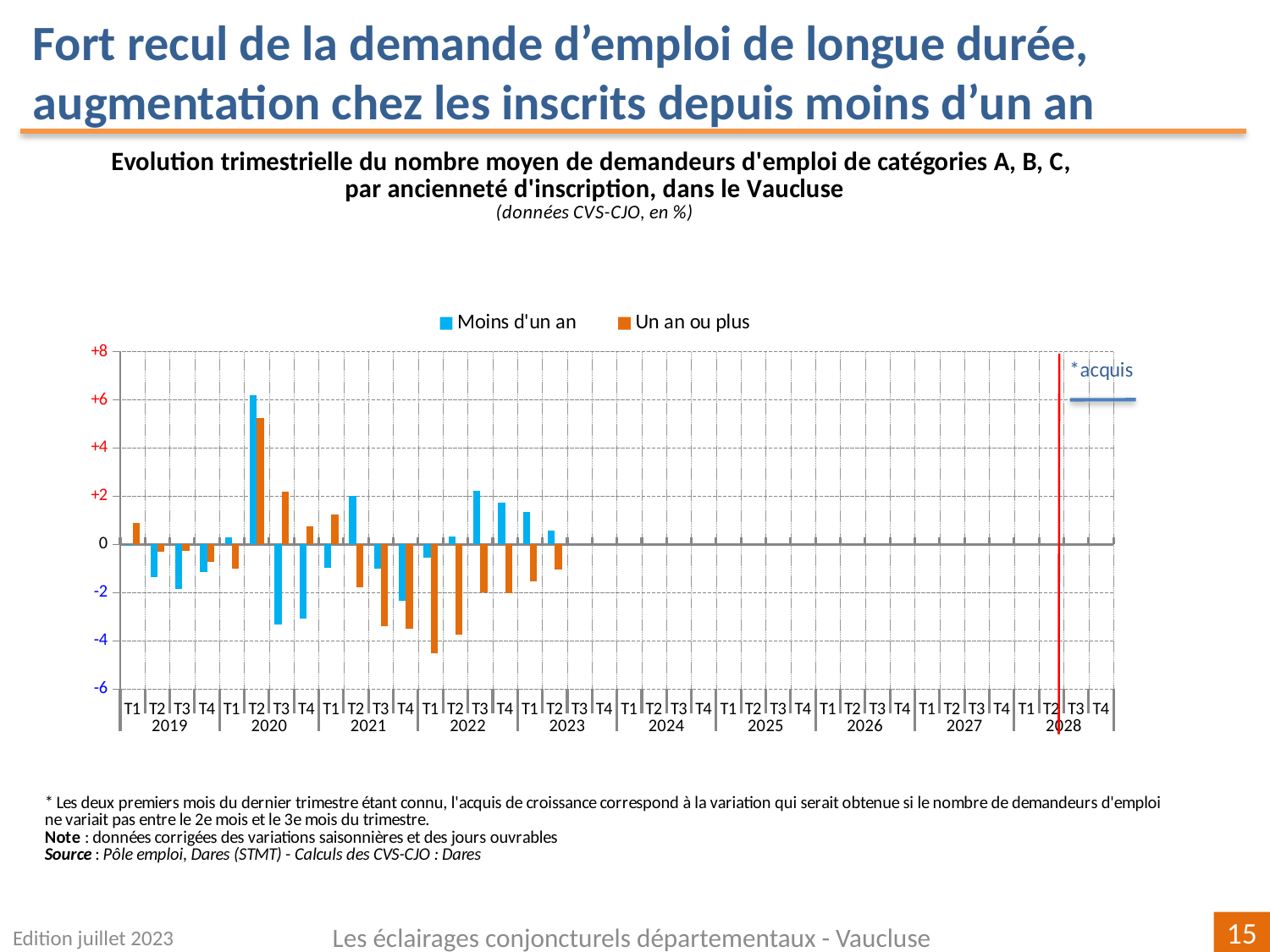
How many years are labelled along the x axis? 10 Is the value for 'Moins d'un an' in T2 2020 greater or less than +4? greater In T3 2020, which series has the larger value, 'Moins d'un an' or 'Un an ou plus'? Un an ou plus In which quarter does the 'Un an ou plus' series reach its highest value? T2 2020 Which colour represents the series 'Un an ou plus'? orange In which quarter does the 'Moins d'un an' series reach its highest value? T2 2020 In which quarter does the 'Un an ou plus' series reach its lowest value? T1 2022 In T2 2020, which series has the larger value, 'Moins d'un an' or 'Un an ou plus'? Moins d'un an What kind of chart is shown on the slide? bar chart How many series does the legend list? 2 Is the value for 'Un an ou plus' in T1 2022 greater or less than -4? less What are the two series named in the legend? Moins d'un an; Un an ou plus